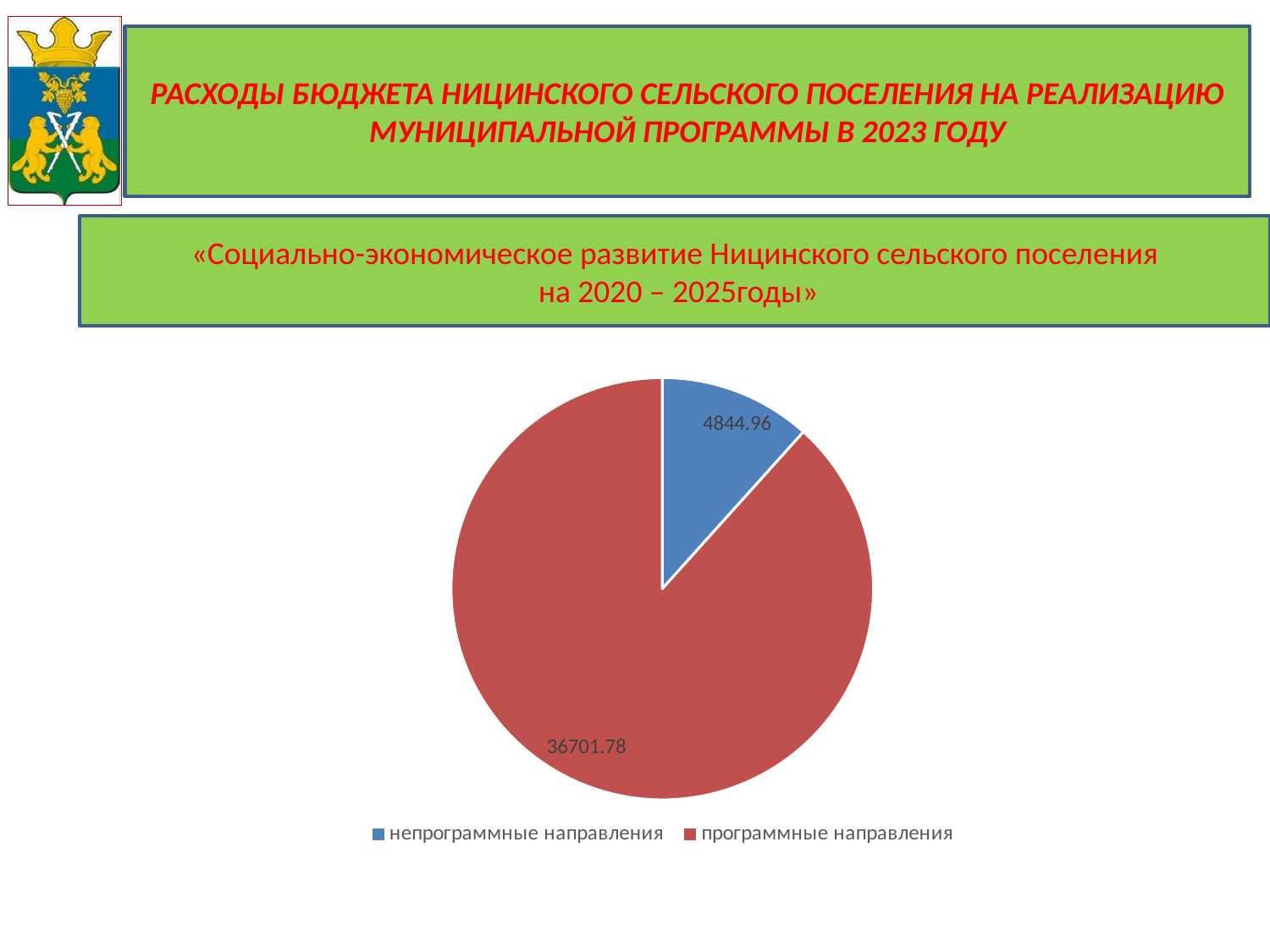
What is the value for непрограммные направления in the pie chart? 4844.96 What colour is the slice for непрограммные направления? blue Which category has the smallest slice in the pie chart? непрограммные направления What is the difference between программные направления and непрограммные направления? 31856.82 How many slices does the pie chart have? 2 Which category has the largest slice in the pie chart? программные направления What is the value for программные направления in the pie chart? 36701.78 What share of the pie does программные направления represent? 88.3% What share of the pie does непрограммные направления represent? 11.7% What is the total of the two slices in the pie chart? 41546.74 Which is larger: непрограммные направления or программные направления? программные направления What kind of chart is shown on the slide? pie chart